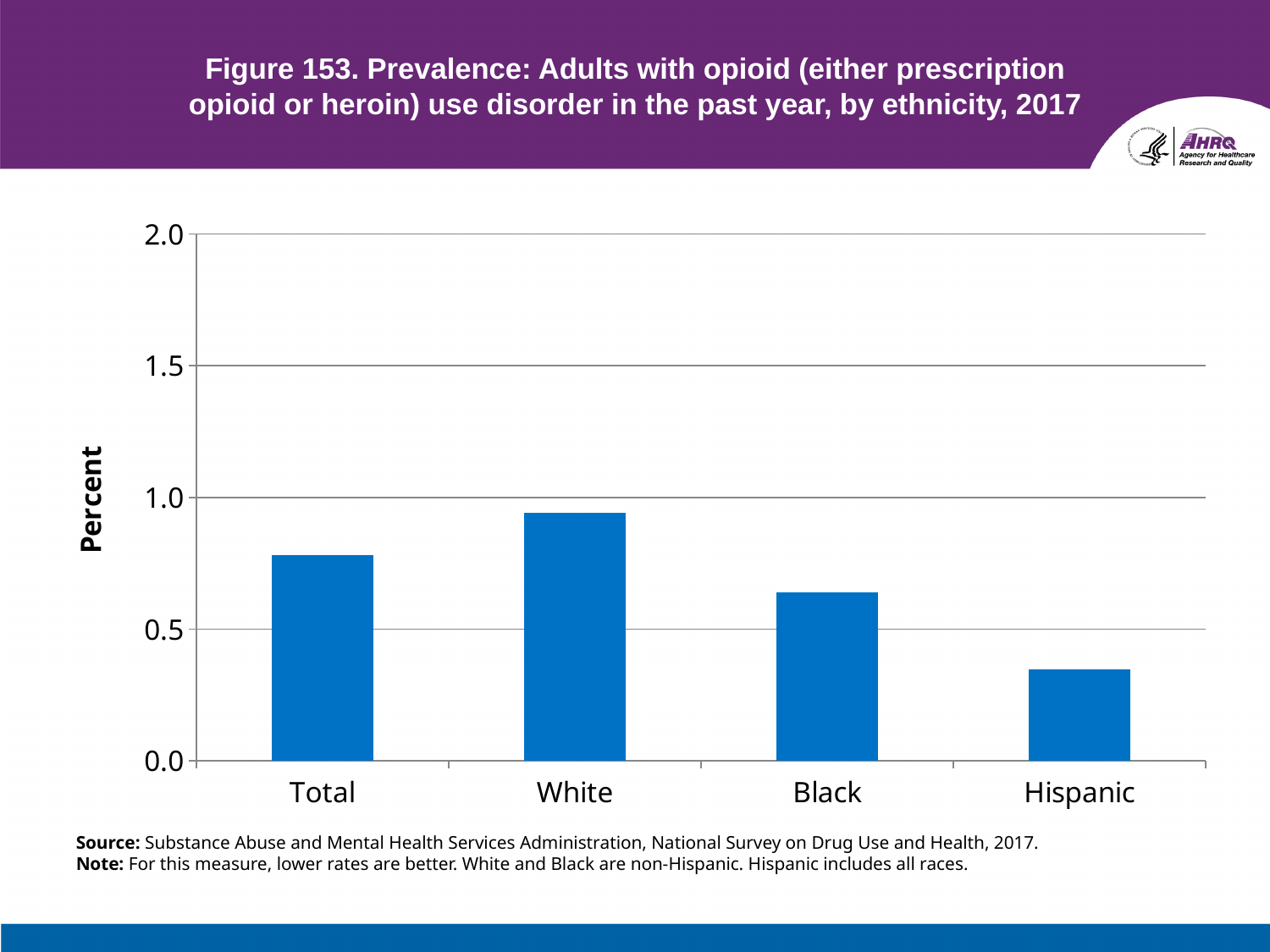
Is the value for Total greater or less than 0.5? greater What is the label on the y axis of the chart? Percent What kind of chart is shown on the slide? bar chart How many categories are shown on the x axis of the chart? 4 What is the highest value shown on the y axis of the chart? 2.0 Which category has the highest value in the chart? White Is the value for Hispanic greater or less than 0.5? less Is the value for Black greater or less than 1.0? less Which is larger, the value for Total or the value for White? White Which category has the lowest value in the chart? Hispanic Which is larger, the value for Black or the value for Hispanic? Black